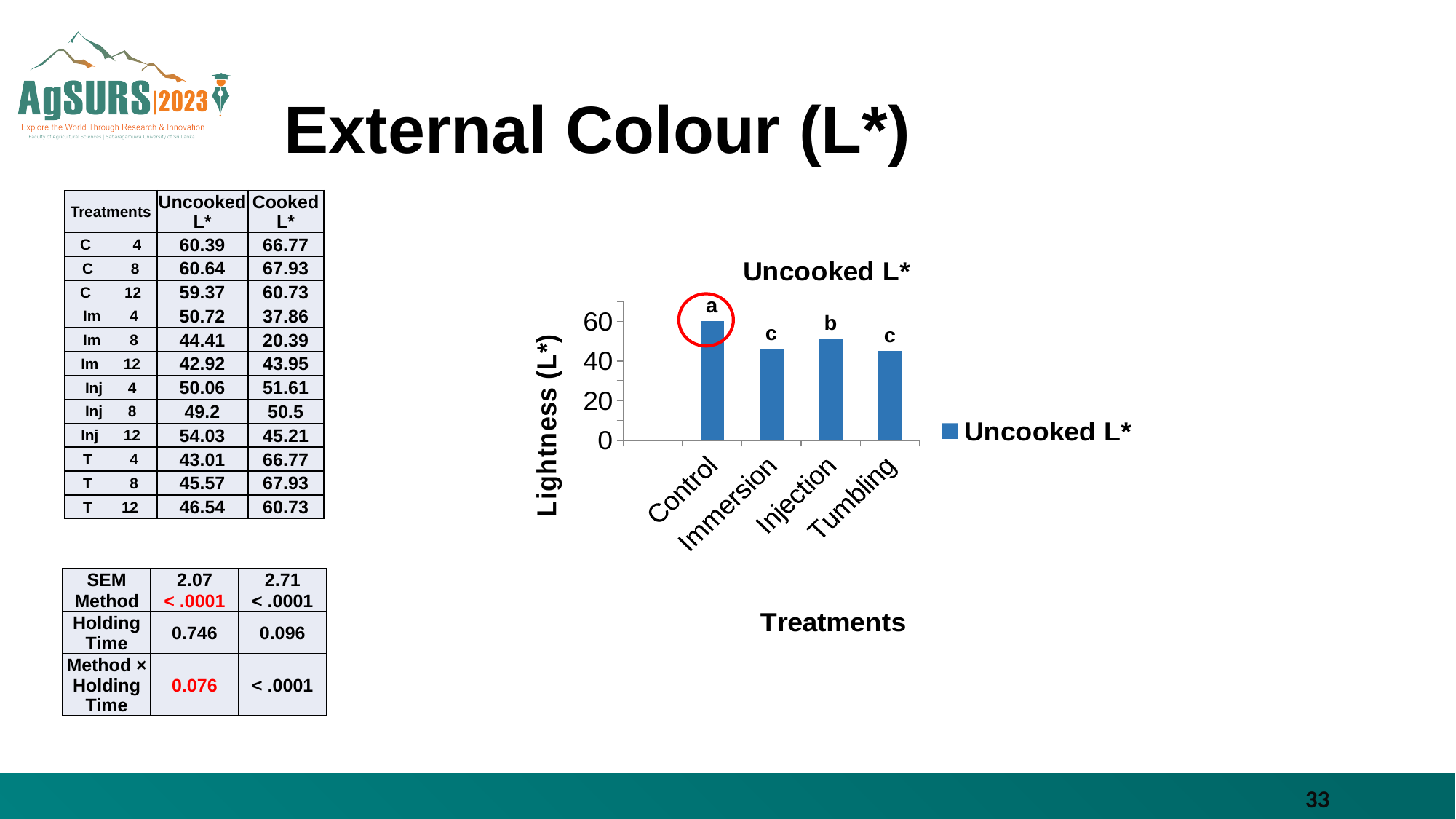
In the Uncooked L* chart, is the bar for Injection greater or less than 40? greater How many series does the legend of the Uncooked L* chart list? 1 How many treatment categories are plotted in the Uncooked L* chart? 4 In the Uncooked L* chart, is the bar for Tumbling greater or less than 60? less In the Uncooked L* chart, which bar is taller, Control or Injection? Control In the Uncooked L* chart, is the bar for Control greater or less than 40? greater What kind of chart is shown on the slide? bar chart What is the label on the vertical axis of the Uncooked L* chart? Lightness (L*) In the Uncooked L* chart, which bar is taller, Injection or Immersion? Injection Which bar in the Uncooked L* chart is marked with the letter "a" and circled in red? Control Which treatment has the highest bar in the Uncooked L* chart? Control